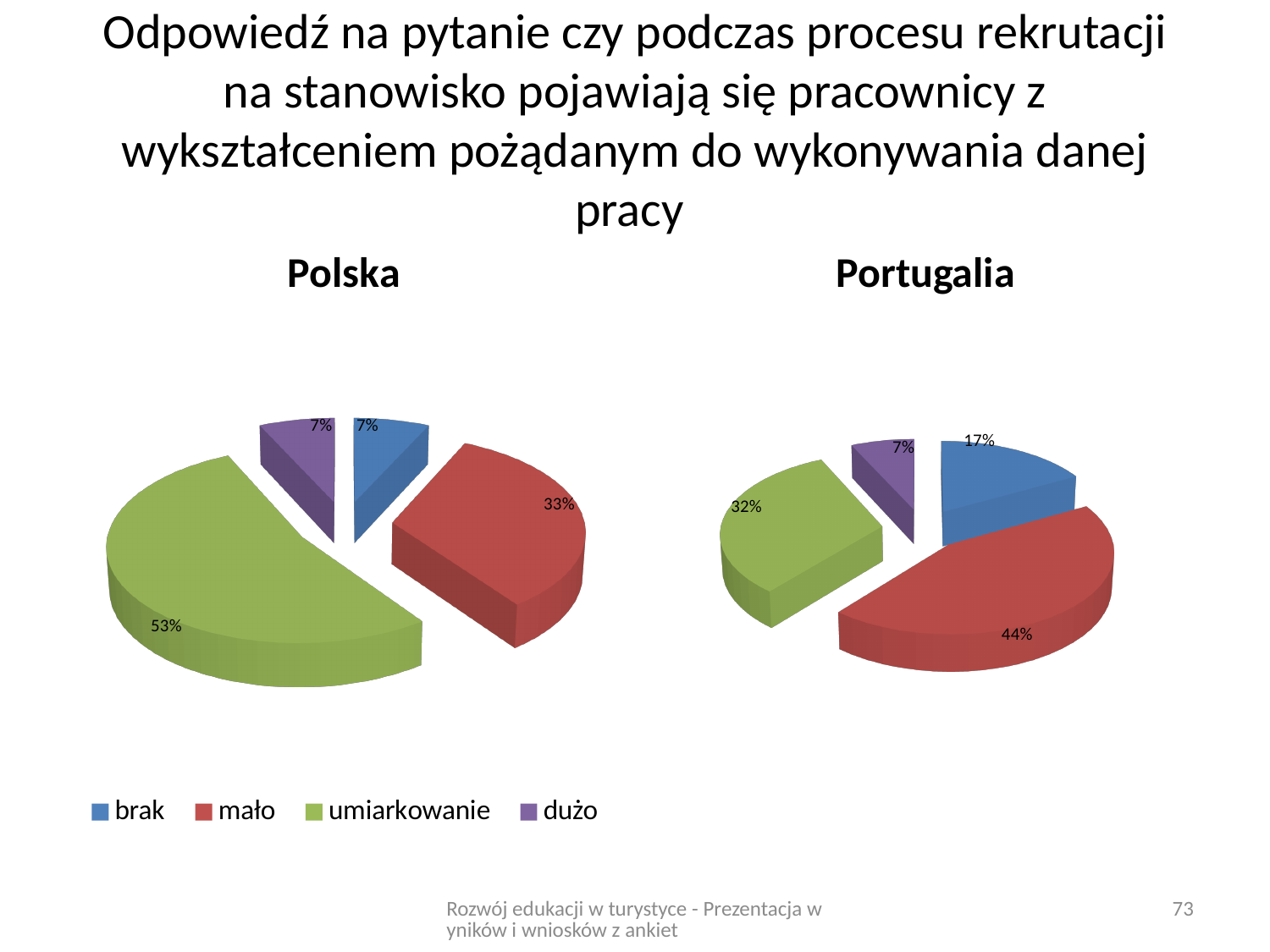
How many categories does the legend list? 4 In the Portugalia chart, which category has the smallest slice? dużo Which is larger: the brak share in the Polska chart or the brak share in the Portugalia chart? Portugalia Which colour represents dużo in the legend? purple In the Portugalia chart, which category has the largest slice? mało In the Polska chart, which category has the largest slice? umiarkowanie In the Polska chart, what share is labelled for umiarkowanie? 53% In the Portugalia chart, what share is labelled for brak? 17% What kind of chart is the Polska chart? pie chart In the Portugalia chart, what share is labelled for mało? 44% In the Polska chart, what share is labelled for mało? 33% What is the difference between the umiarkowanie share in the Polska chart and the umiarkowanie share in the Portugalia chart? 21 percentage points